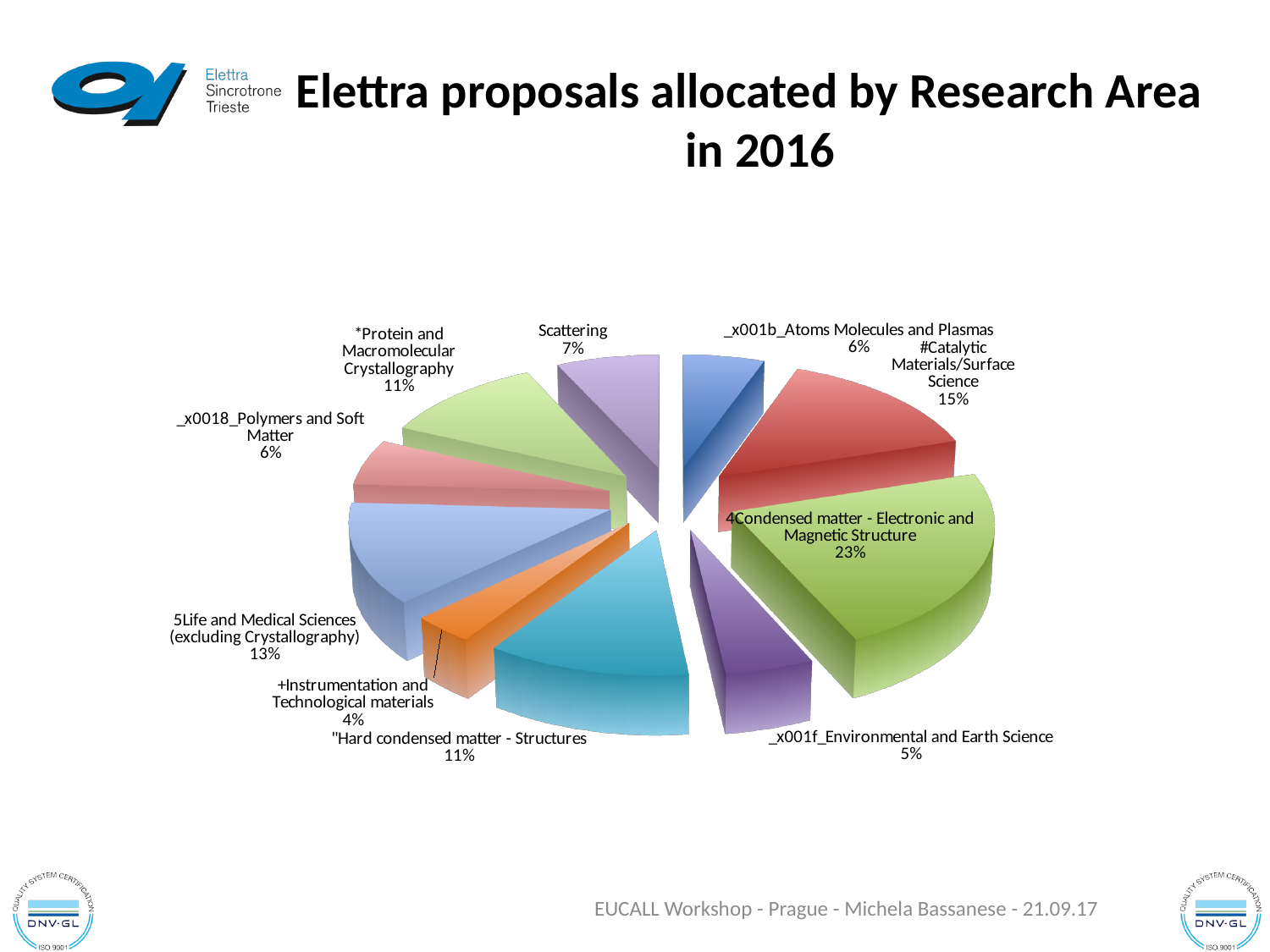
Which has a larger share: Scattering or Polymers and Soft Matter? Scattering What is the difference in percentage points between Condensed matter - Electronic and Magnetic Structure and Catalytic Materials/Surface Science? 8 percentage points What percentage of proposals went to Catalytic Materials/Surface Science? 15% Which research area has the smallest share of proposals? Instrumentation and Technological materials What share is shown for Environmental and Earth Science? 5% How many research areas (slices) are shown in the pie chart? 10 Which research area has the largest share of proposals? Condensed matter - Electronic and Magnetic Structure What share is shown for Life and Medical Sciences (excluding Crystallography)? 13% What percentage is shown for Instrumentation and Technological materials? 4% What is the title of the chart? Elettra proposals allocated by Research Area in 2016 What type of chart is shown on the slide? Pie chart What share of Elettra proposals in 2016 was allocated to Condensed matter - Electronic and Magnetic Structure? 23%